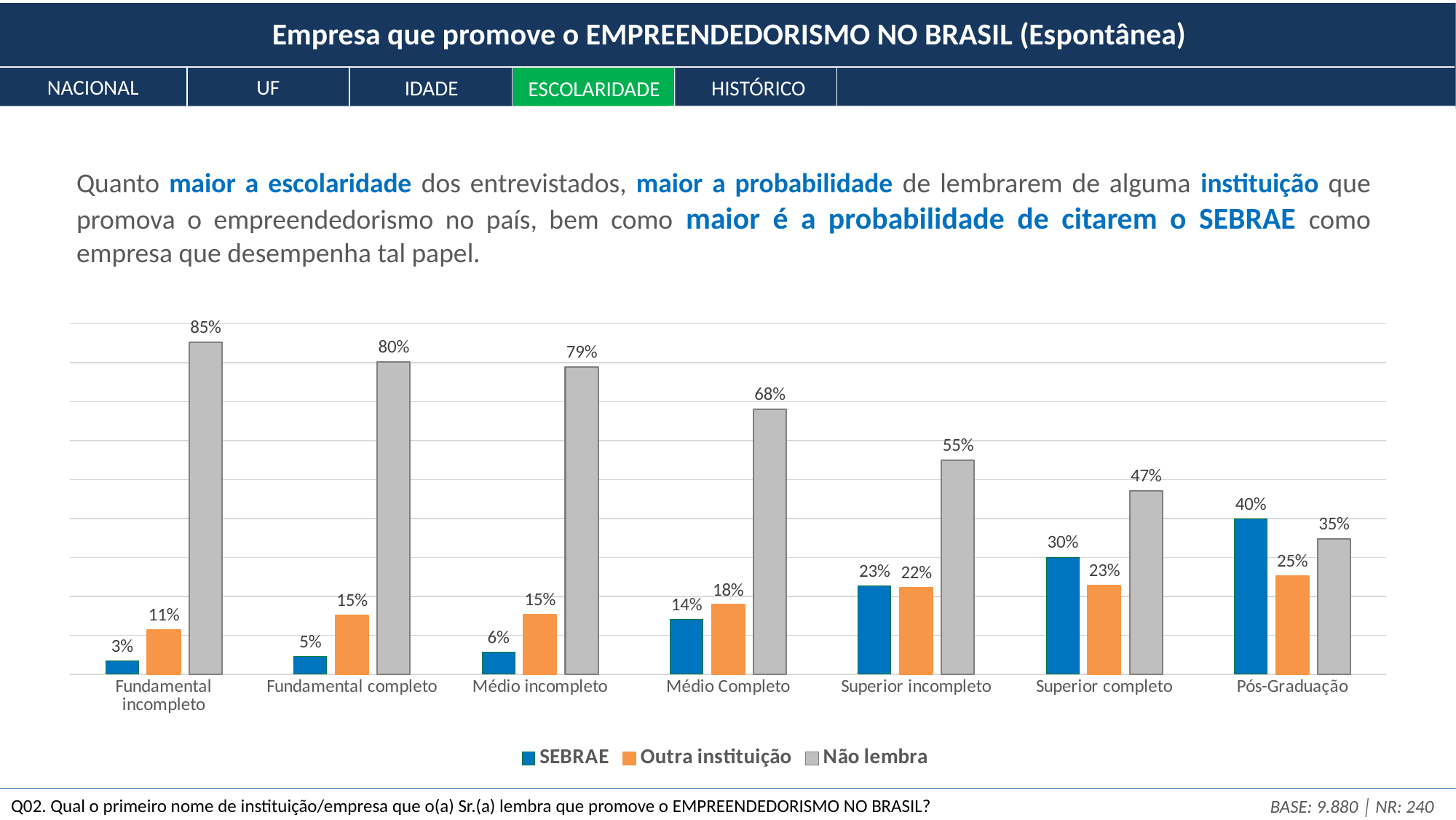
What is the Outra instituição value for Médio Completo? 18% How many series does the legend list? 3 What is the SEBRAE value for Pós-Graduação? 40% Do the SEBRAE values rise or fall from Fundamental incompleto to Pós-Graduação? Rise Which category has the highest SEBRAE value? Pós-Graduação Which is larger for Superior completo: SEBRAE or Outra instituição? SEBRAE How many education categories are shown on the x axis? 7 What kind of chart is shown on the slide? Bar chart What is the Não lembra value for Fundamental incompleto? 85% Which category has the lowest Não lembra value? Pós-Graduação Which series is shown in grey in the legend? Não lembra What is the difference between the Não lembra values for Fundamental incompleto and Pós-Graduação? 50%